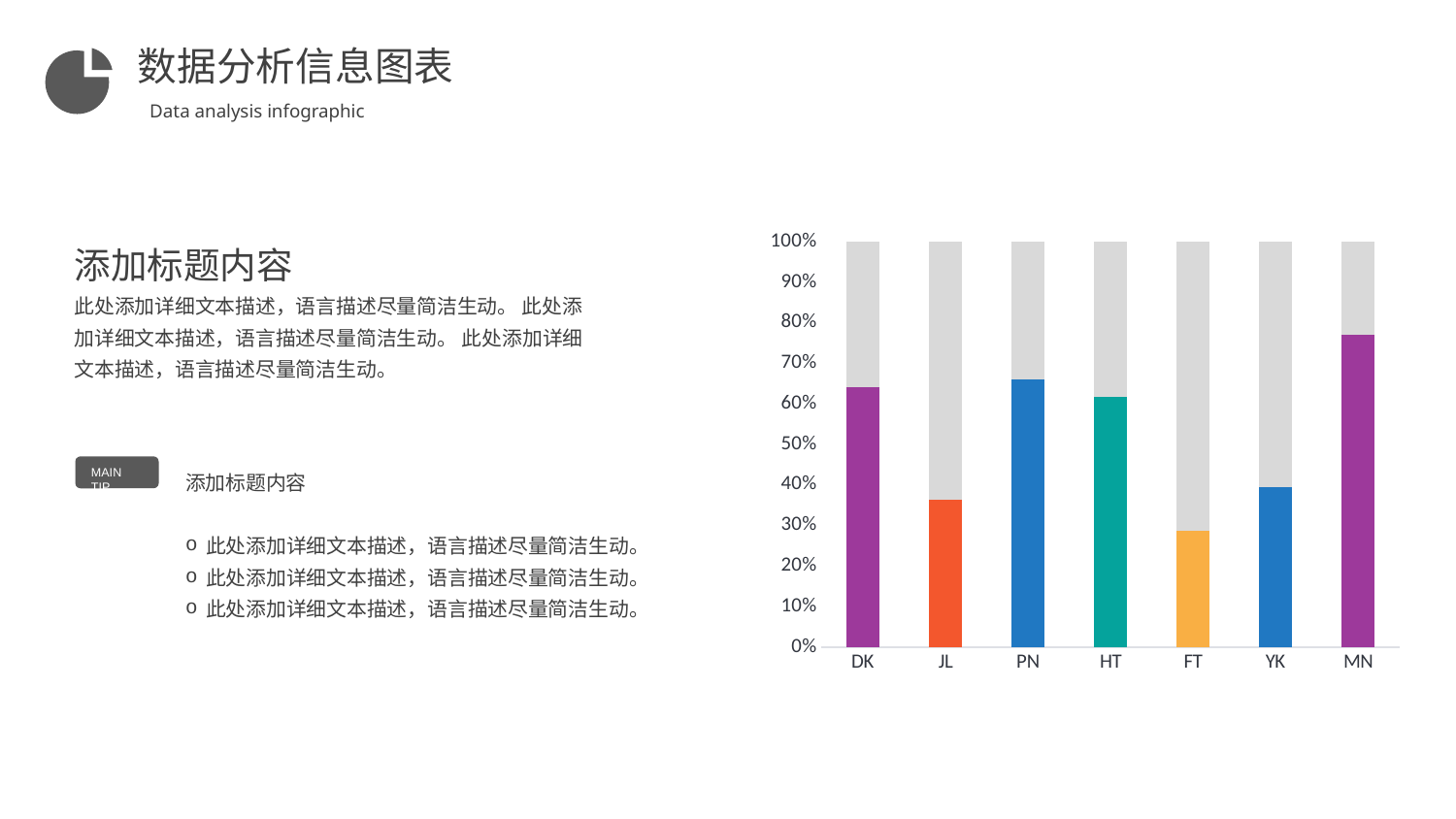
What kind of chart is shown on the slide? bar chart Is the coloured value for MN greater or less than 70%? greater Which category has the tallest coloured segment in the chart? MN Is the coloured value for YK greater or less than 50%? less What is the total height of each stacked bar in the chart? 100% Which has the larger coloured value, DK or FT? DK Is the coloured value for JL greater or less than 40%? less How many categories are shown on the x axis of the chart? 7 Which category has the shortest coloured segment in the chart? FT Which has the larger coloured value, MN or JL? MN